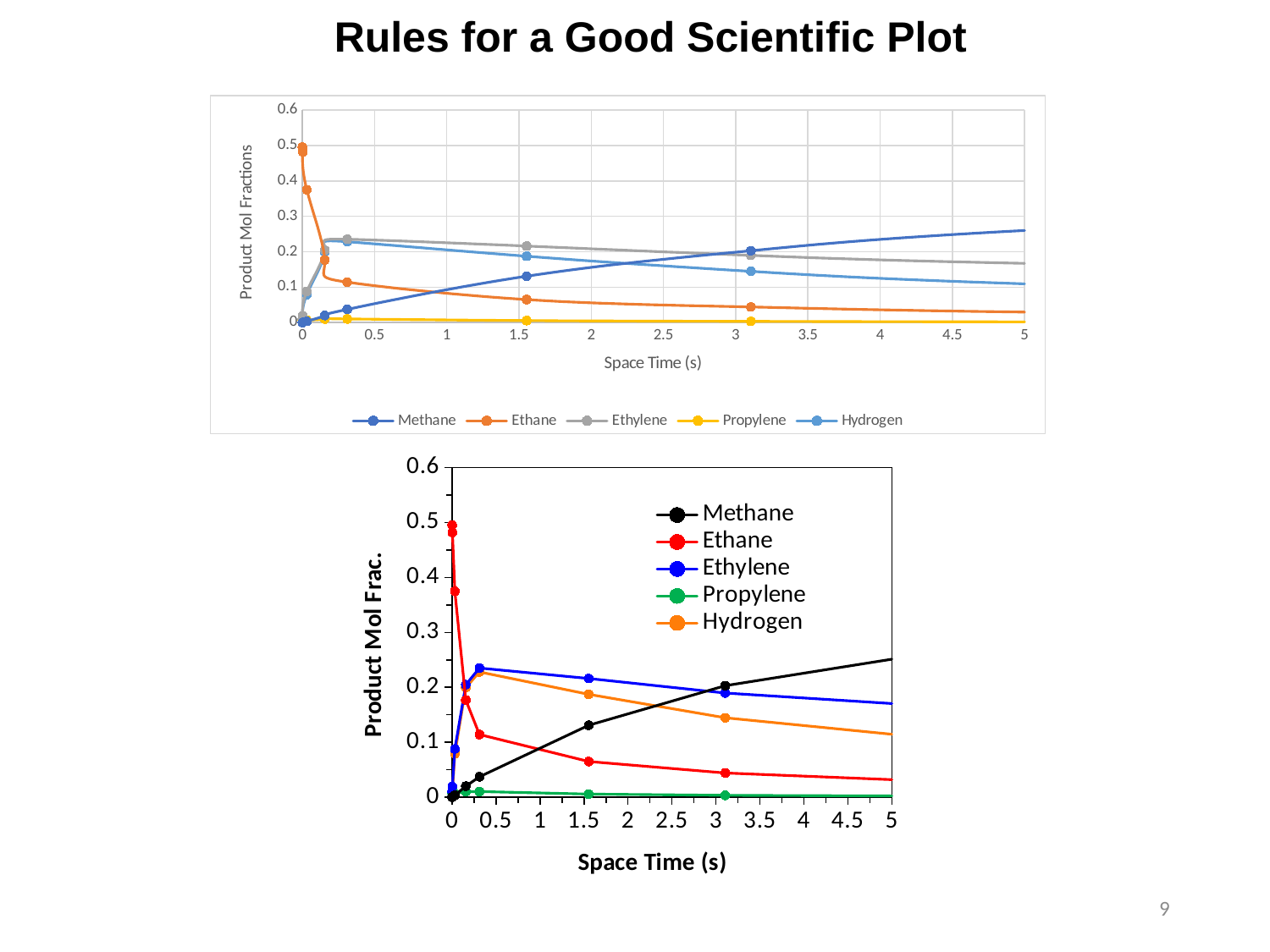
How many series does the legend of the bottom chart list? 5 In the bottom chart, what colour is the Methane series? black In the bottom chart, is the value for Methane at a space time of 5 s greater or less than 0.2? greater In the bottom chart, which series has the highest value at a space time of 5 s? Methane What kind of chart is the bottom chart on the slide? line chart In the bottom chart, which series has the lowest value at a space time of 5 s? Propylene In the bottom chart, is the value for Ethane at a space time of 5 s greater or less than 0.1? less In the bottom chart, does the Methane series rise or fall as space time increases? rise What is the y-axis label of the top chart? Product Mol Fractions In the bottom chart, at a space time of 5 s, which is larger: Ethylene or Hydrogen? Ethylene How many series does the legend of the top chart list? 5 In the top chart, does the Ethane series rise or fall as space time increases? fall